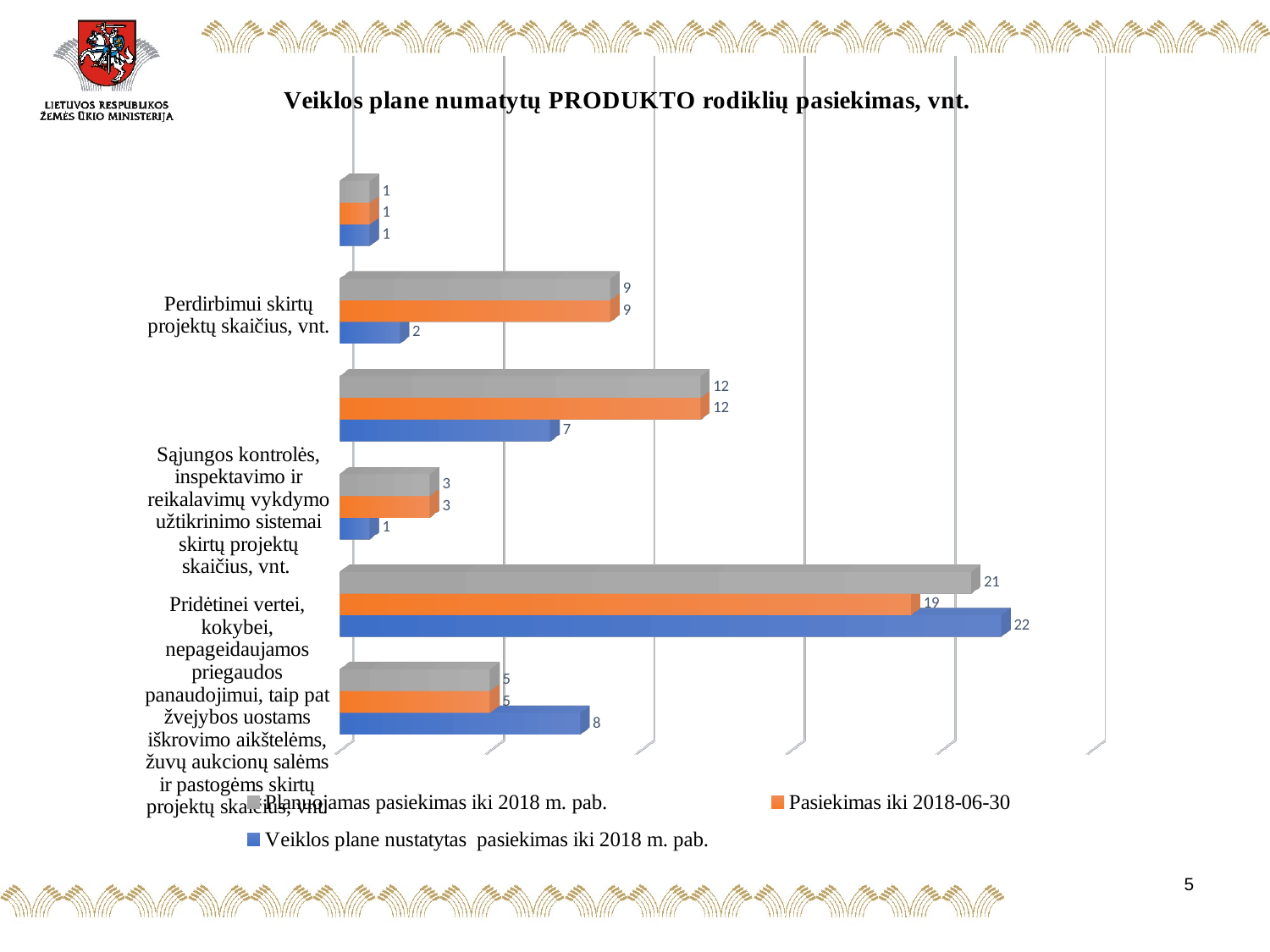
For "Perdirbimui skirtų projektų skaičius, vnt.", what is the difference between "Planuojamas pasiekimas iki 2018 m. pab." and "Veiklos plane nustatytas pasiekimas iki 2018 m. pab."? 7 In the top group of bars, what value do all three series show? 1 In the bottom group of bars, which series has the larger value: "Veiklos plane nustatytas pasiekimas iki 2018 m. pab." or "Pasiekimas iki 2018-06-30"? Veiklos plane nustatytas pasiekimas iki 2018 m. pab. For "Perdirbimui skirtų projektų skaičius, vnt.", what is the value of "Veiklos plane nustatytas pasiekimas iki 2018 m. pab."? 2 Which colour represents the series "Pasiekimas iki 2018-06-30" in the legend? Orange How many groups of bars are plotted in the chart? 6 What kind of chart is shown on the slide? Bar chart How many series does the legend list? 3 What is the title of the chart? Veiklos plane numatytų PRODUKTO rodiklių pasiekimas, vnt. For "Perdirbimui skirtų projektų skaičius, vnt.", what is the value of "Pasiekimas iki 2018-06-30"? 9 What is the largest value labelled anywhere in the chart? 22 In the group of bars with values 21, 19 and 22, what is the difference between "Planuojamas pasiekimas iki 2018 m. pab." and "Pasiekimas iki 2018-06-30"? 2